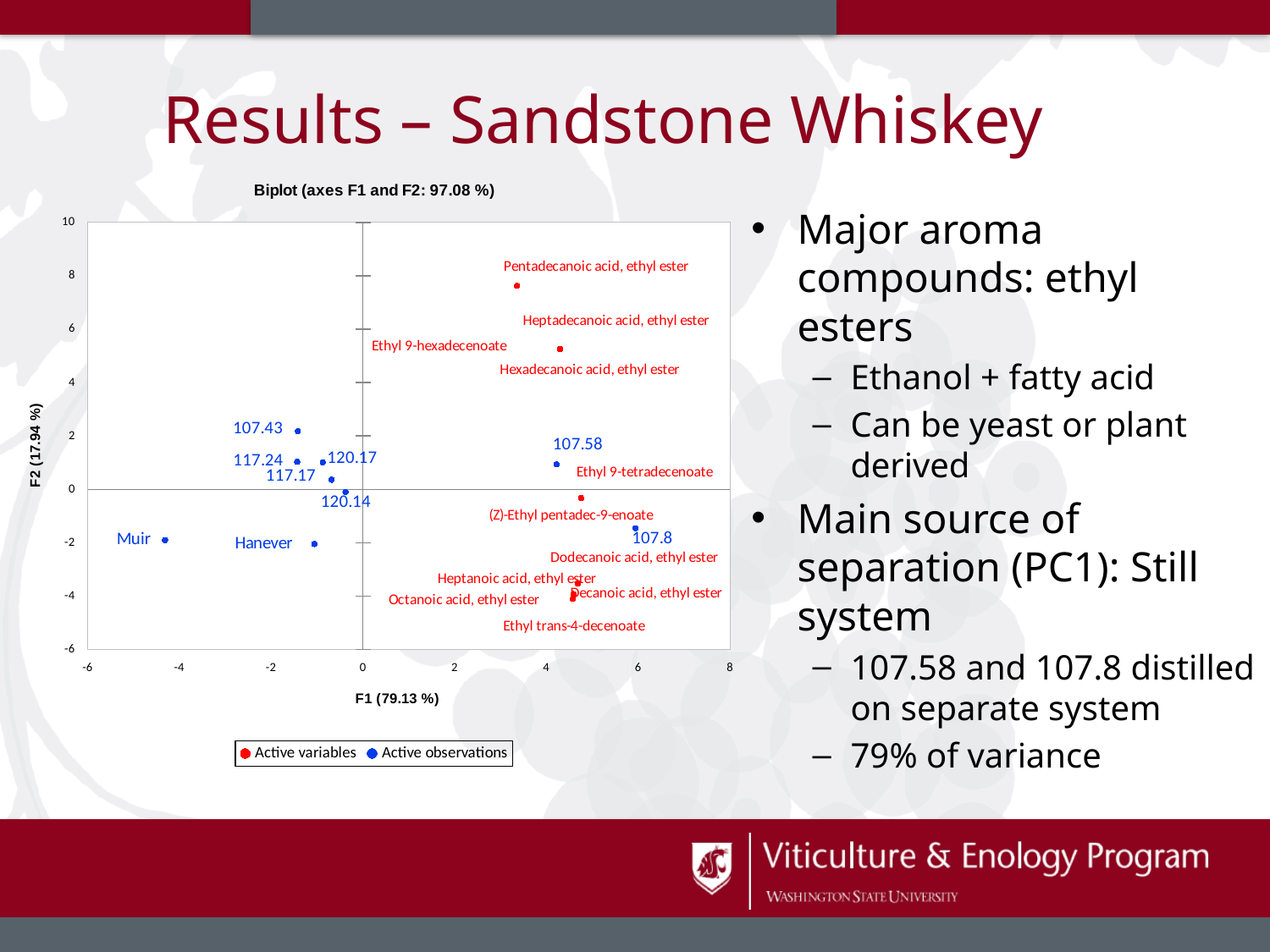
Which active variable has the highest F2 value? Pentadecanoic acid, ethyl ester Is the F1 value for Muir greater or less than -4? less How many active observations (blue points) are plotted on the chart? 9 What kind of chart is shown on the slide? Scatter chart (biplot) What is the label of the horizontal axis of the chart? F1 (79.13 %) What is the title of the chart? Biplot (axes F1 and F2: 97.08 %) Is the F1 value for 107.58 greater or less than 2? greater Which active observation has the highest F1 value? 107.8 Is the F2 value for Pentadecanoic acid, ethyl ester greater or less than 6? greater Which has the higher F2 value, 107.43 or Hanever? 107.43 How many series does the chart legend list? 2 Which active observation has the lowest F1 value? Muir